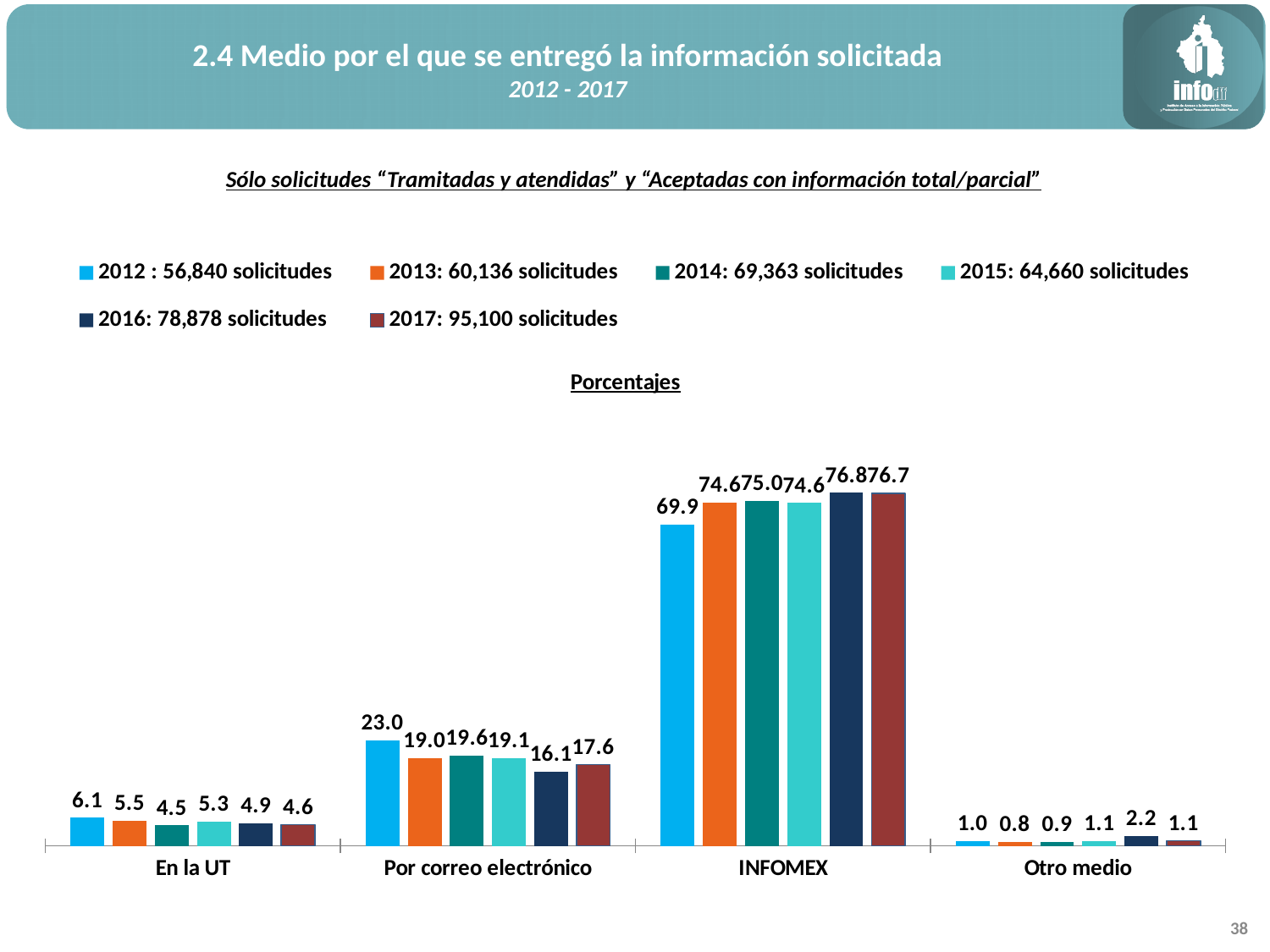
Which is larger for INFOMEX: the 2012 value or the 2016 value? 2016 What is the value for Otro medio in the 2016 series? 2.2 How many categories are shown on the x axis? 4 According to the legend, how many solicitudes were there in 2017? 95,100 Which category has the highest value in the 2017 series? INFOMEX What type of chart is shown on the slide? bar chart What is the difference between the 2012 and 2016 values for Por correo electrónico? 6.9 What is the value for INFOMEX in the 2012 series? 69.9 What is the value for Por correo electrónico in the 2016 series? 16.1 What is the value for En la UT in the 2014 series? 4.5 How many series does the legend list? 6 Which year has the lowest value for Por correo electrónico? 2016